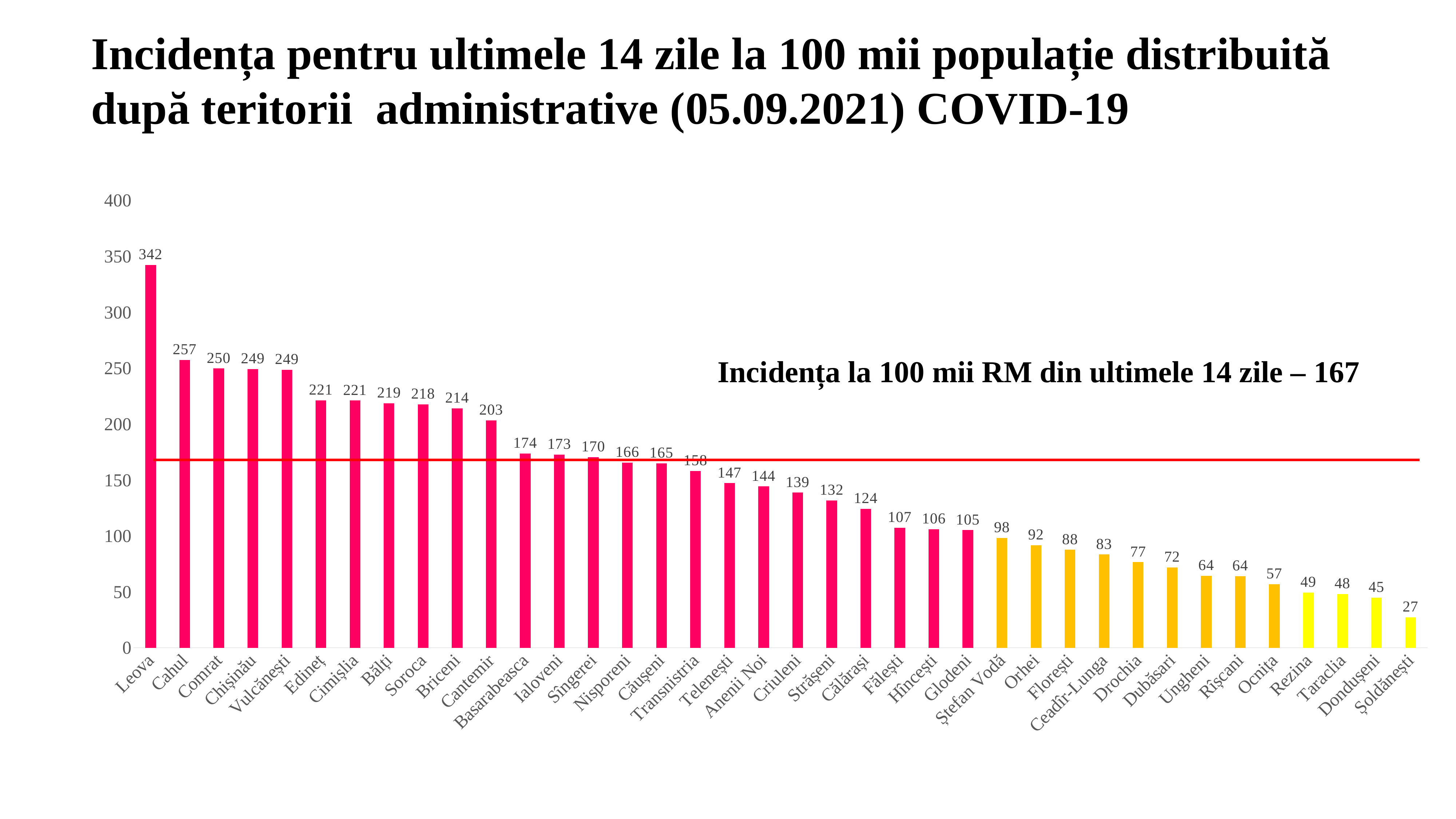
How many territories are shown on the chart? 38 What kind of chart is shown on the slide? bar chart Which has a larger value, Soroca or Ungheni? Soroca What is the value for Leova? 342 Which territory has the highest value? Leova Is the value for Cantemir greater or less than 200? greater What is the value for Chișinău? 249 What value does the horizontal red line on the chart represent, according to the text on the slide? 167 What is the difference between the values for Leova and Cahul? 85 Do the values rise or fall from left to right along the x axis? fall Which territory has the lowest value? Șoldănești What is the value for Orhei? 92